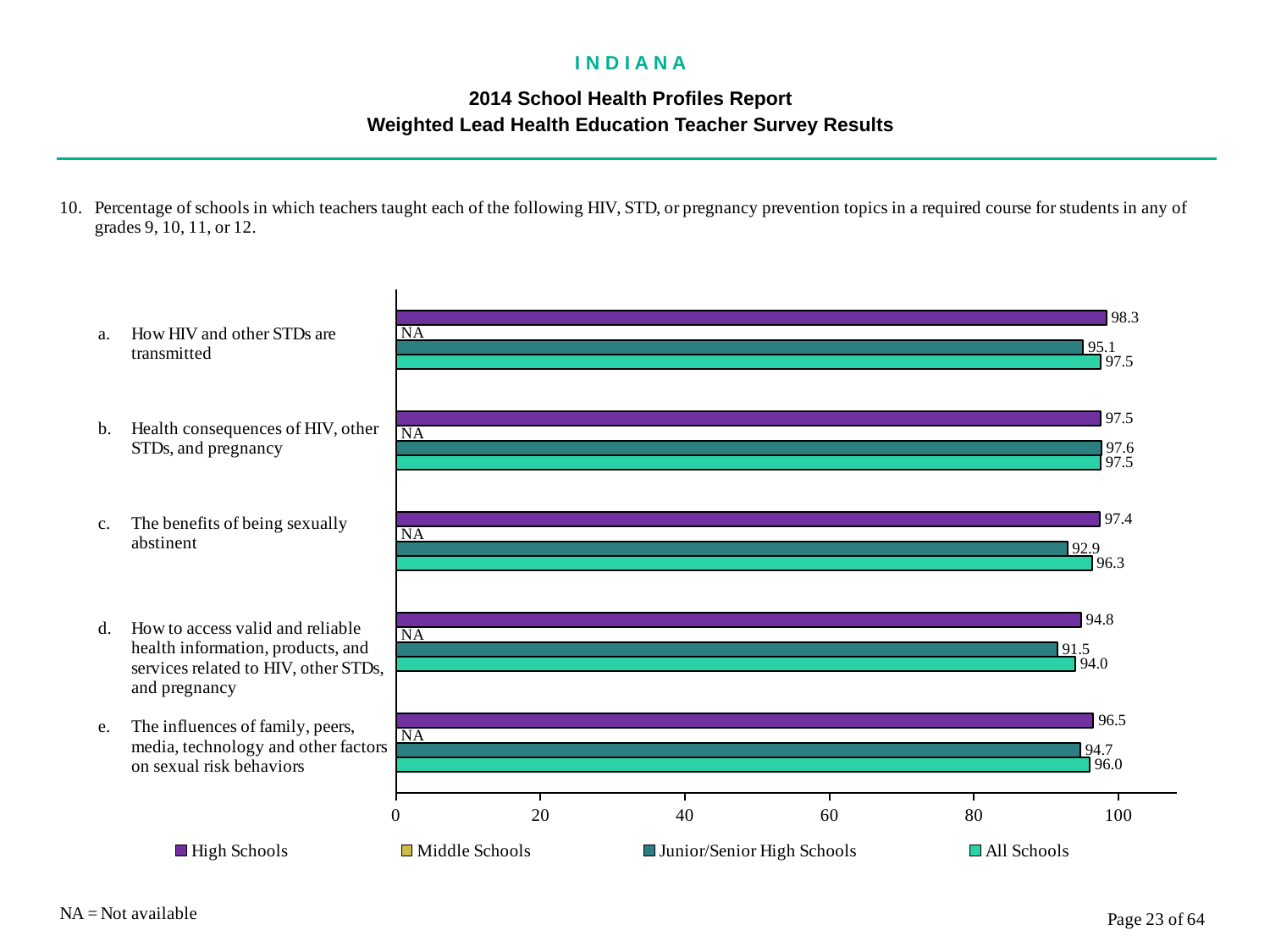
Which legend entry is shown in purple? High Schools Which topic has the highest High Schools value? How HIV and other STDs are transmitted What is the All Schools value for 'How to access valid and reliable health information, products, and services related to HIV, other STDs, and pregnancy'? 94.0 What is the High Schools value for 'How HIV and other STDs are transmitted'? 98.3 How many series does the legend list? 4 What kind of chart is shown on the slide? Bar chart For 'Health consequences of HIV, other STDs, and pregnancy', which is larger: the High Schools value or the Junior/Senior High Schools value? Junior/Senior High Schools What value is shown for Middle Schools across all topics? NA How many topics (categories) are shown in the chart? 5 What is the Junior/Senior High Schools value for 'The benefits of being sexually abstinent'? 92.9 Which topic has the lowest Junior/Senior High Schools value? How to access valid and reliable health information, products, and services related to HIV, other STDs, and pregnancy What is the difference between the High Schools and Junior/Senior High Schools values for 'The influences of family, peers, media, technology and other factors on sexual risk behaviors'? 1.8